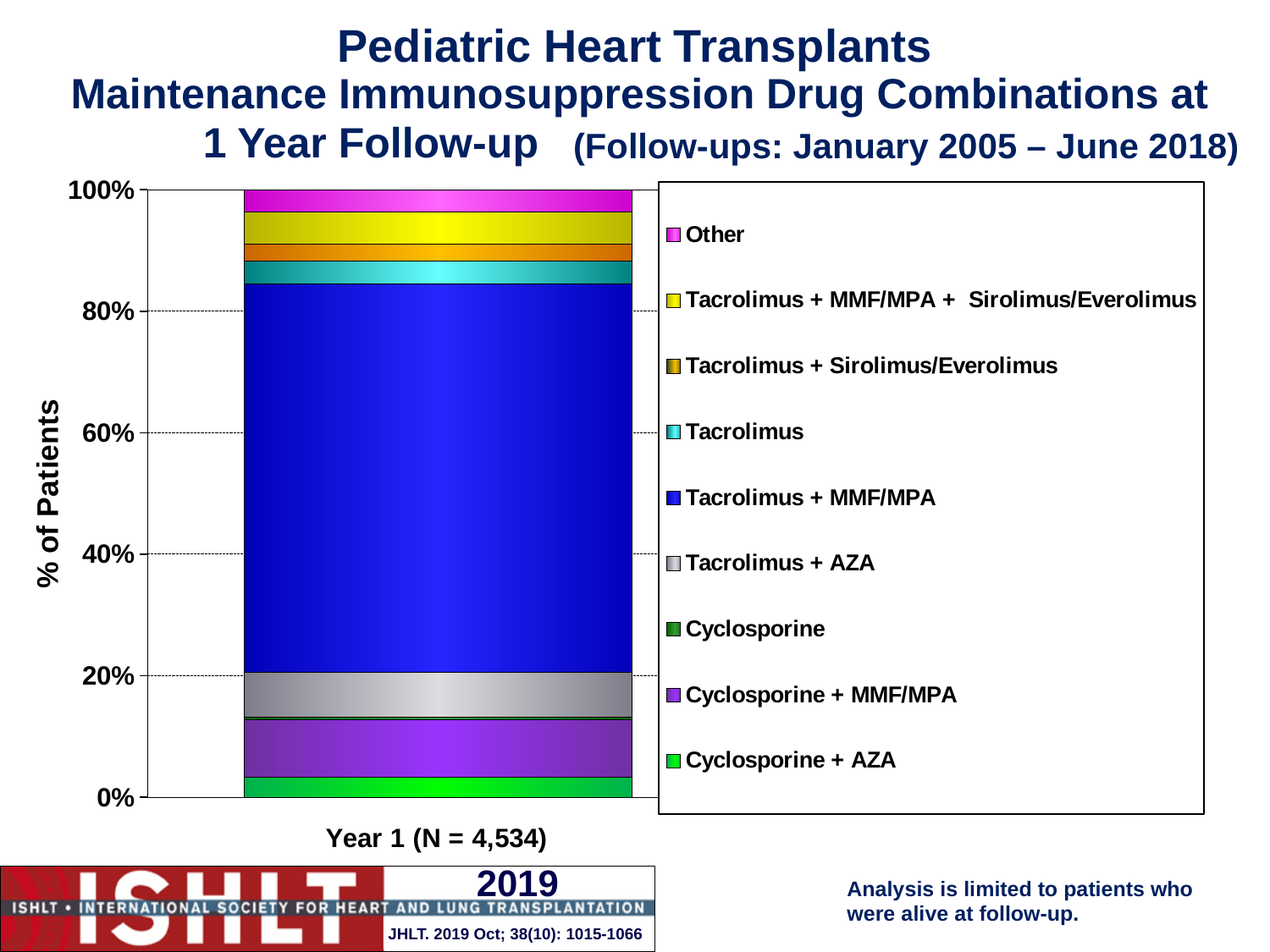
What is the label of the single bar on the x axis? Year 1 (N = 4,534) Which drug combination accounts for the largest share of patients at Year 1? Tacrolimus + MMF/MPA What kind of chart is shown on the slide? Stacked bar chart Is the share of patients on Tacrolimus + MMF/MPA greater or less than 40%? greater Which drug combination accounts for the smallest share of patients at Year 1? Cyclosporine What is the y-axis label of the chart? % of Patients How many bars (categories) are plotted on the x axis? 1 How many series does the legend list? 9 Is the share of patients on Cyclosporine + MMF/MPA greater or less than 20%? less Which is larger: the share of patients on Tacrolimus + MMF/MPA or on Cyclosporine + MMF/MPA? Tacrolimus + MMF/MPA